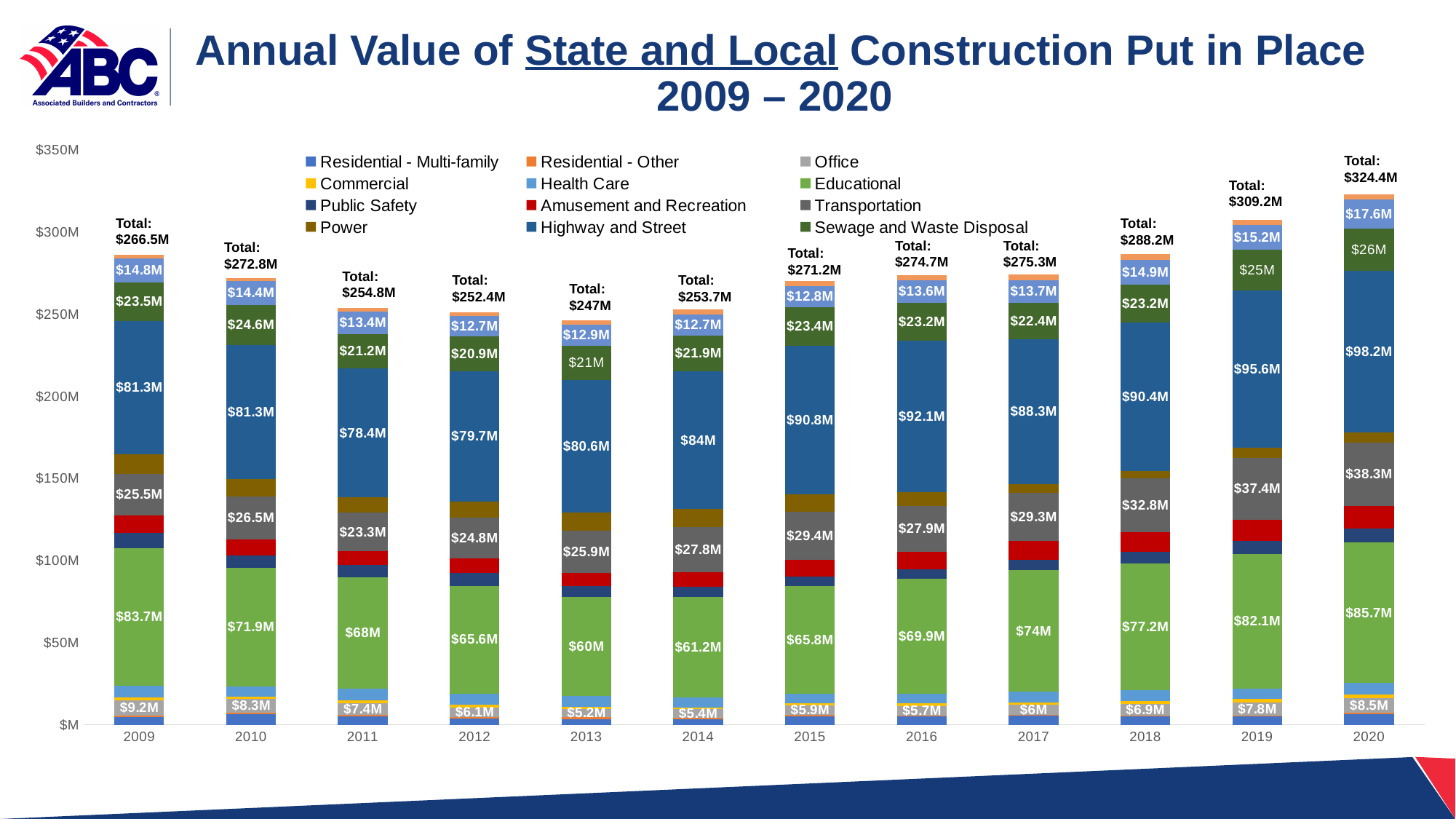
Which year has the larger Educational value, 2009 or 2020? 2020 How many series does the legend list? 12 Which year has the highest total value of construction put in place? 2020 Which year has the lowest total value of construction put in place? 2013 What kind of chart is shown on the slide? Stacked bar chart What is the total value of state and local construction put in place in 2020? $324.4M How much larger is the 2020 total than the 2009 total? $57.9M What is the Sewage and Waste Disposal value for 2019? $25M Is the total height of the 2020 bar greater or less than $300M? greater What is the Highway and Street value for 2015? $90.8M How many years are shown on the x axis? 12 What is the Educational value for 2013? $60M